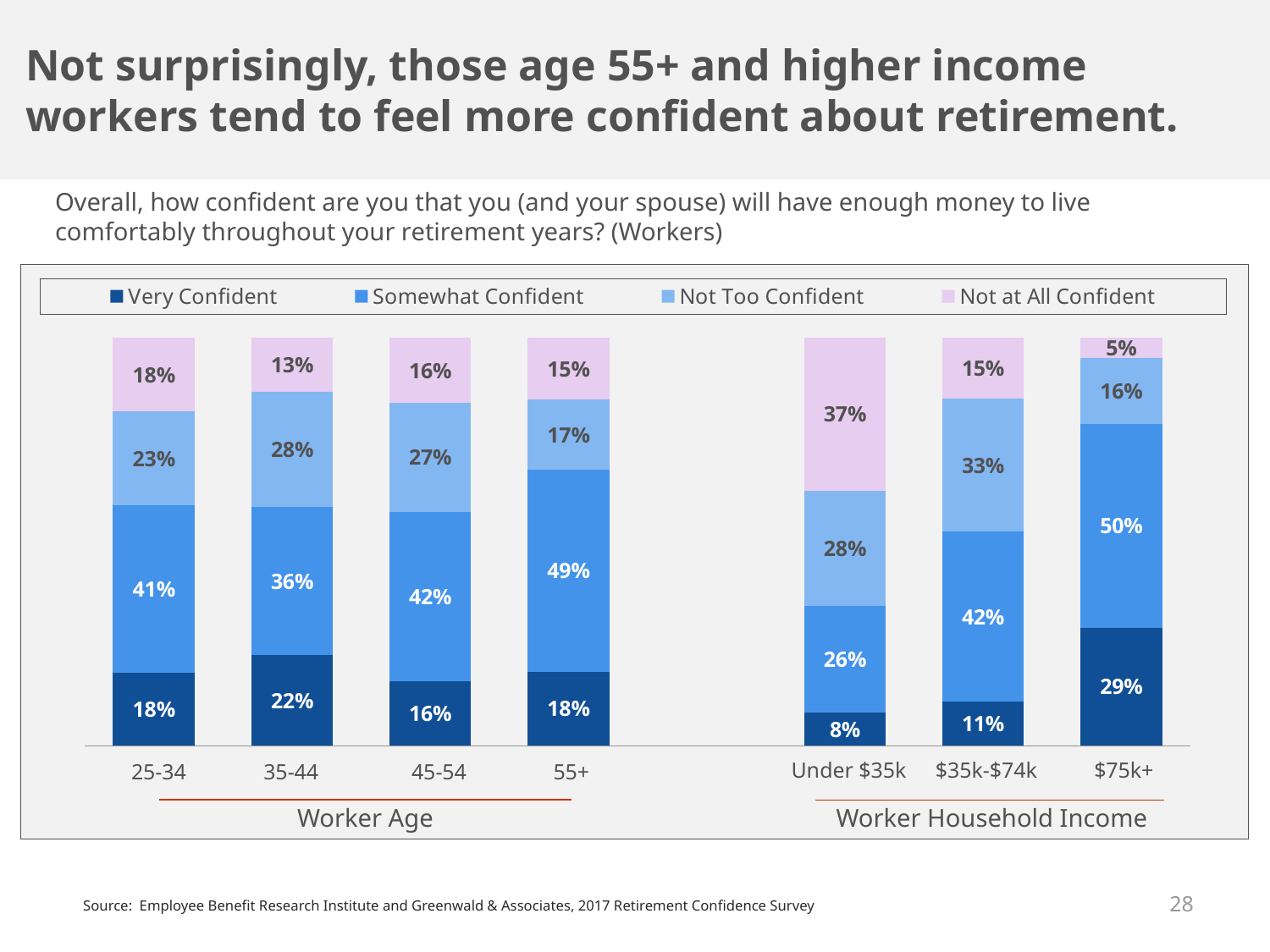
How many categories are shown on the x axis? 7 What percentage of workers aged 35-44 are Very Confident? 22% What are the two group labels shown beneath the x axis? Worker Age and Worker Household Income What percentage of workers aged 55+ are Somewhat Confident? 49% Which category has the highest Very Confident percentage? $75k+ Which is larger: the Somewhat Confident percentage for 45-54 or for 35-44? 45-54 What is the difference between the Very Confident percentage for $75k+ and for Under $35k? 21 percentage points What kind of chart is shown on the slide? Stacked bar chart How many series does the legend list? 4 Which category has the lowest Very Confident percentage? Under $35k What is the total of the stacked bar for the 25-34 age group? 100% What percentage of workers with household income under $35k are Not at All Confident? 37%